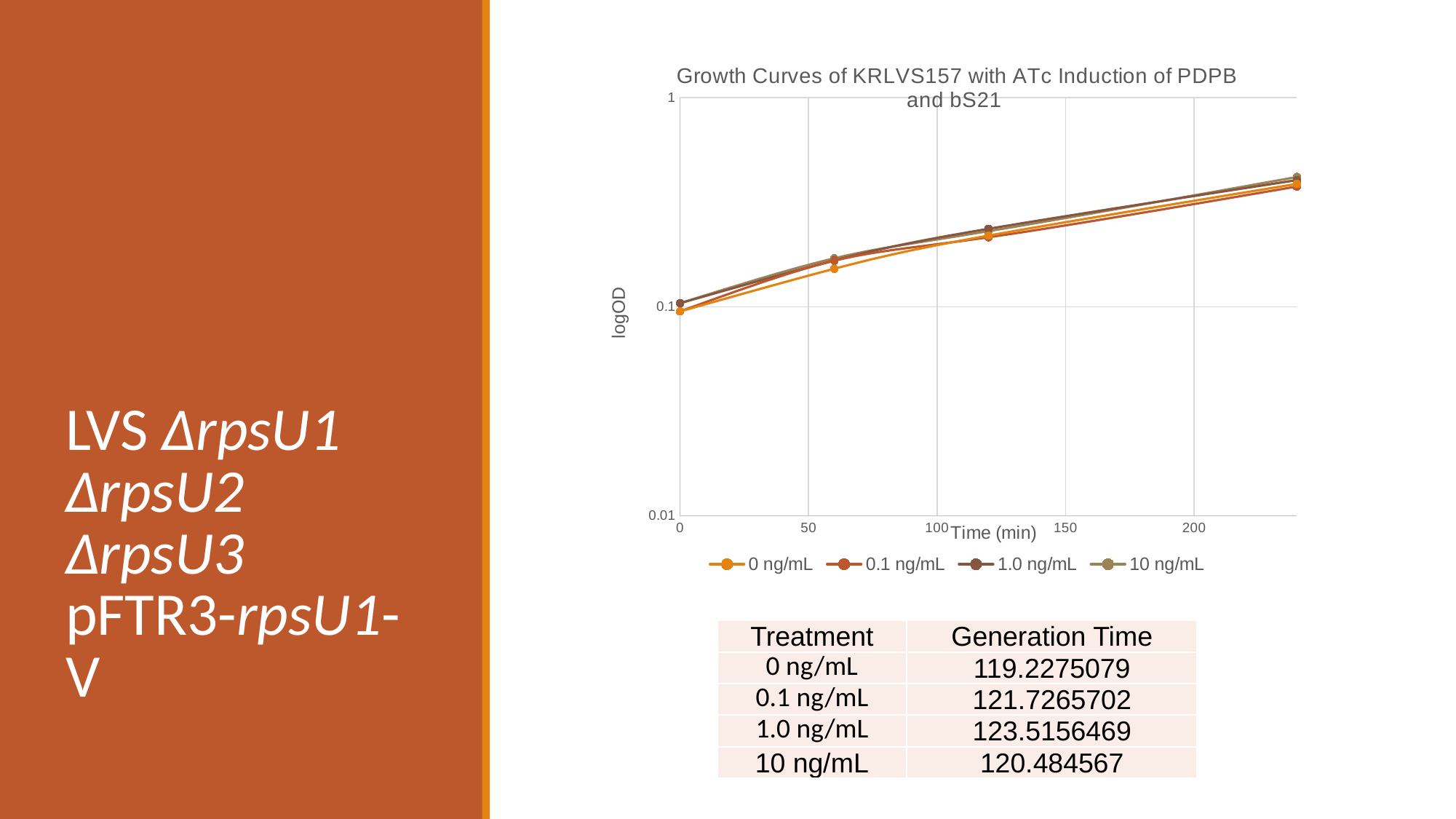
Do the logOD values rise or fall as time increases along the x axis? rise How many series does the chart legend list? 4 What kind of chart is shown on the slide? line chart How many time points are plotted for each series in the chart? 4 What is the label of the y axis of the chart? logOD Is the logOD value for 10 ng/mL at the final time point greater or less than 1? less Is the logOD value for 0 ng/mL at the final time point greater or less than 0.1? greater What is the title of the chart? Growth Curves of KRLVS157 with ATc Induction of PDPB and bS21 Which series in the chart legend is listed first? 0 ng/mL